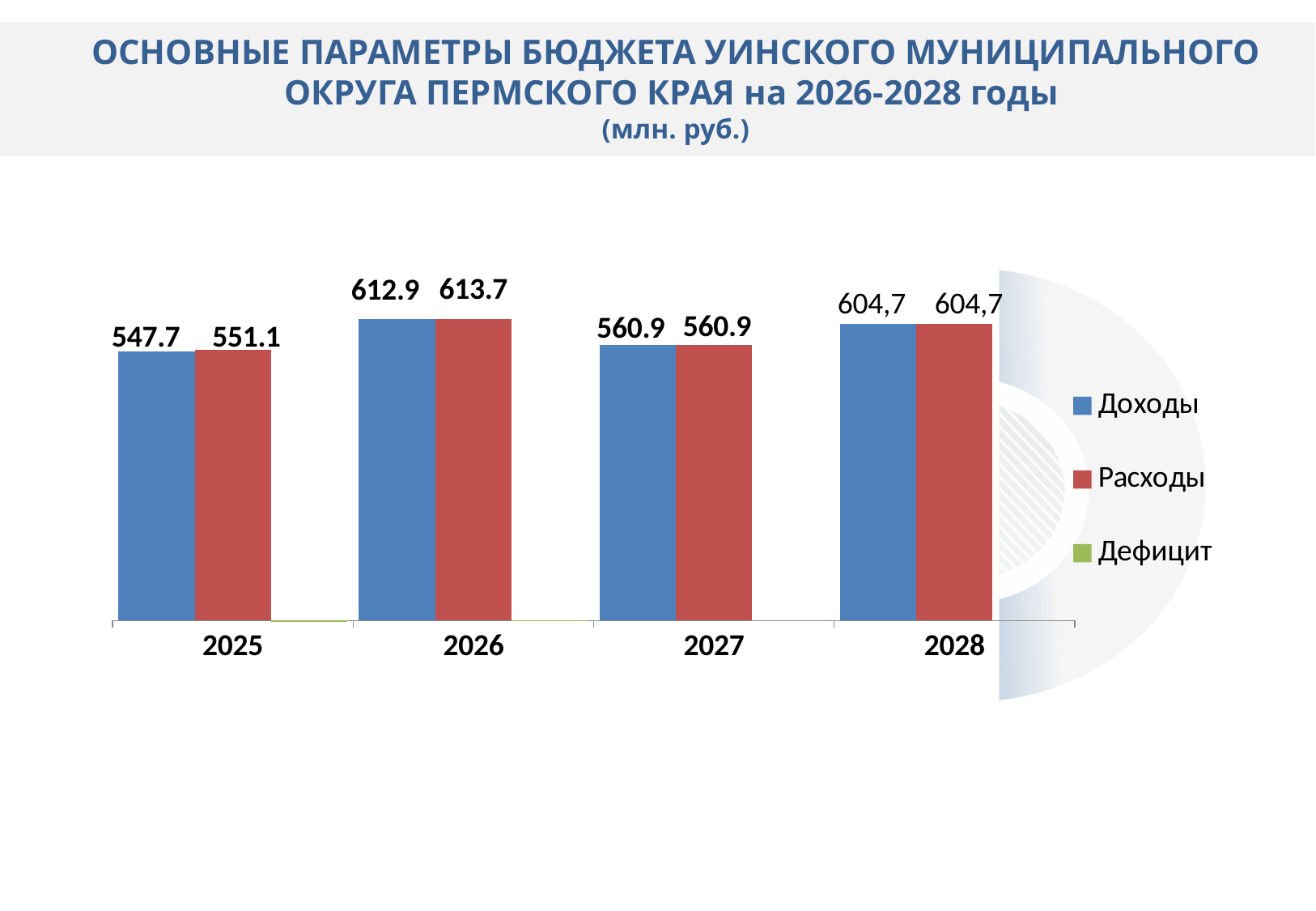
By how much did Доходы increase from 2025 to 2026? 65.2 What is the value of Расходы for 2027? 560.9 In which year is Расходы lowest? 2025 How many years are shown on the x axis? 4 In which year is Доходы highest? 2026 What is the value of Доходы for 2028? 604,7 What is the difference between Расходы and Доходы in 2025? 3.4 What is the value of Расходы for 2026? 613.7 How many series does the legend list? 3 What is the value of Доходы for 2025? 547.7 Which is larger in 2025, Доходы or Расходы? Расходы What kind of chart is shown on the slide? Bar chart